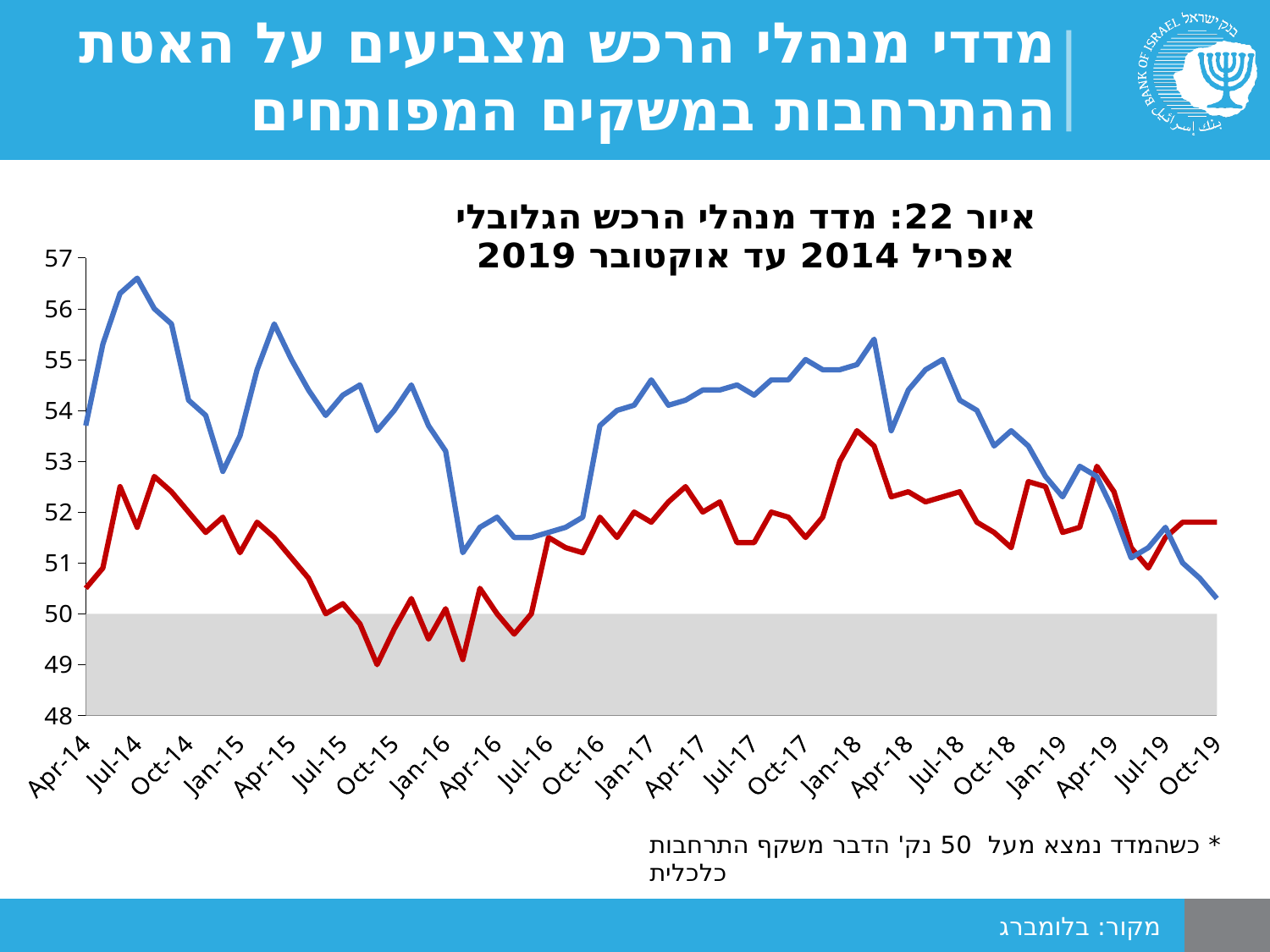
How many date labels are shown on the x axis? 23 Is the value of the blue line at Jul-14 greater or less than 56? greater Is the value of the red line at Jan-18 greater or less than 53? greater How many lines are plotted on the chart? 2 At Oct-19, which line has the higher value, the blue line or the red line? the red line Does the blue line rise or fall between Jan-19 and Oct-19? fall Is the value of the blue line at Oct-19 greater or less than 51? less At Apr-14, which line has the higher value, the blue line or the red line? the blue line Near which x-axis label does the red line reach its lowest point? Oct-15 What is the highest value shown on the y axis? 57 What kind of chart is shown on the slide? line chart